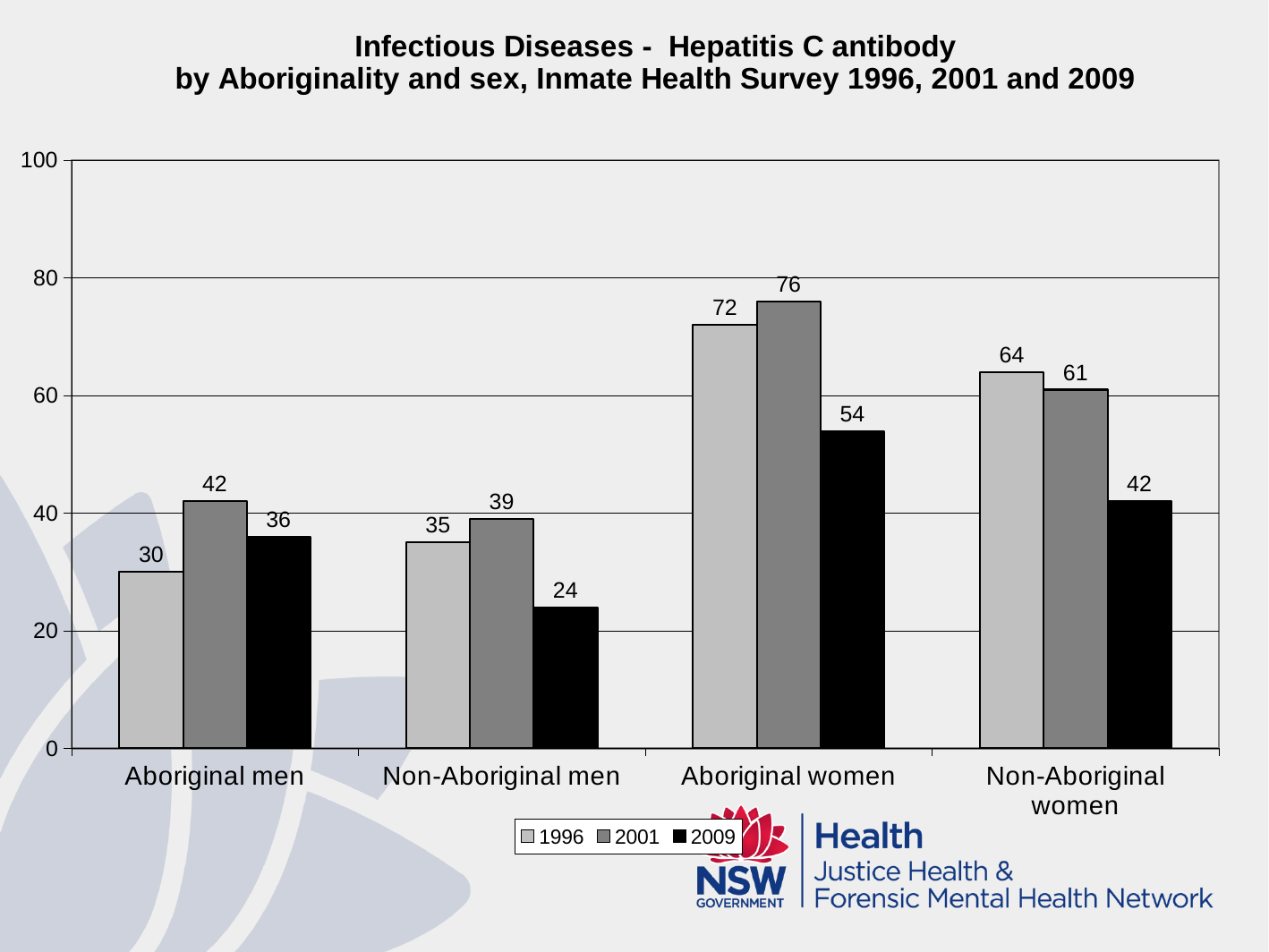
Which series is shown in black in the legend? 2009 Which is larger: the 1996 value for Aboriginal men or the 1996 value for Non-Aboriginal men? Non-Aboriginal men What is the 1996 value for Non-Aboriginal men? 35 What is the difference between the 2001 and 2009 values for Aboriginal women? 22 Which category has the highest 2001 value? Aboriginal women How many series does the legend list? 3 What kind of chart is shown on the slide? Bar chart For Non-Aboriginal women, do the values rise or fall from 1996 to 2009? Fall How many categories are shown on the x axis? 4 What is the 2001 value for Non-Aboriginal women? 61 What is the 2009 value for Aboriginal women? 54 Which category has the lowest 2009 value? Non-Aboriginal men